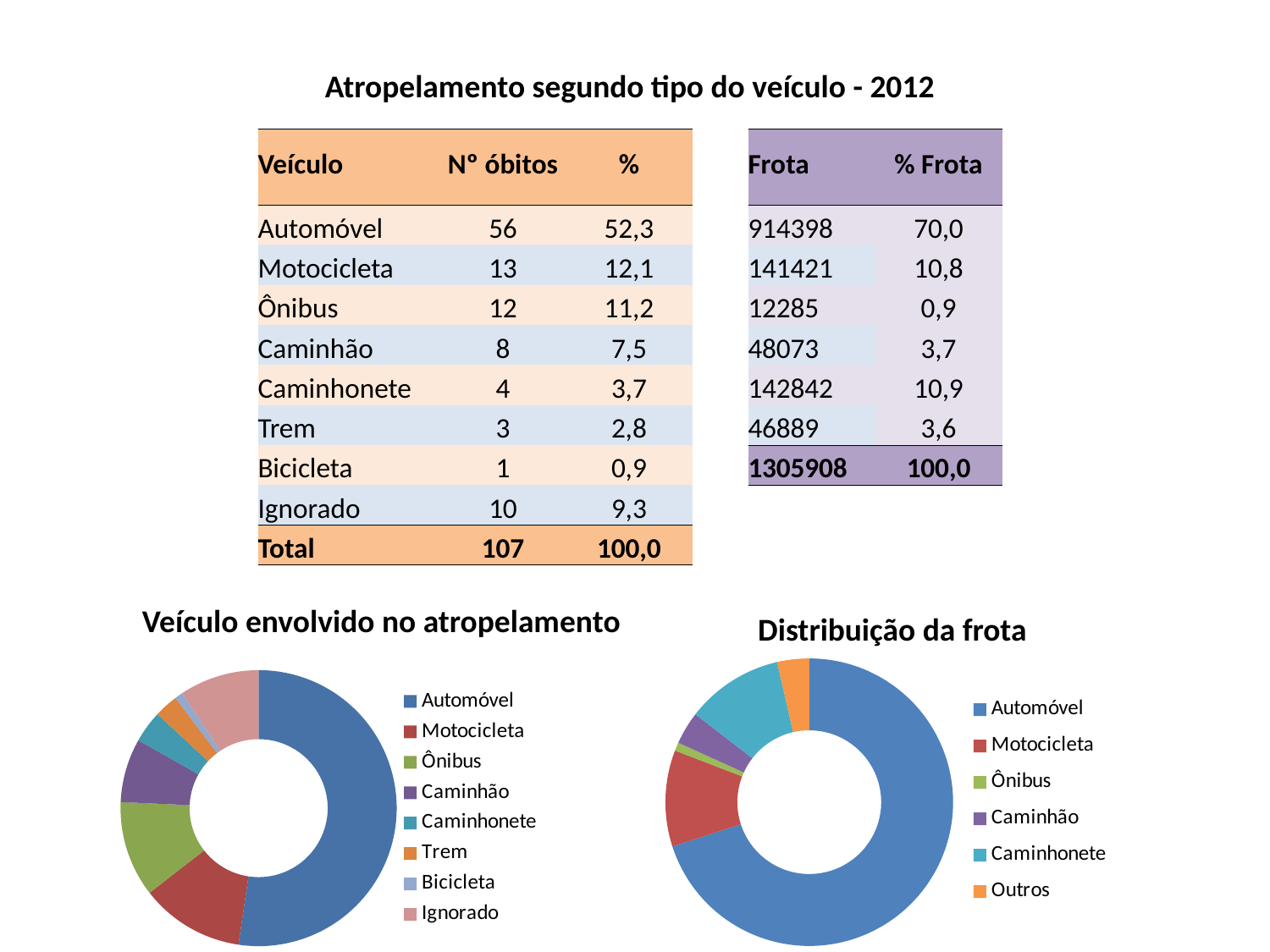
In the 'Veículo envolvido no atropelamento' chart, which category has the smallest slice? Bicicleta What kind of chart is 'Distribuição da frota'? Doughnut chart In the 'Distribuição da frota' chart, which slice is larger: Caminhonete or Caminhão? Caminhonete In the 'Veículo envolvido no atropelamento' chart, which category has the largest slice? Automóvel In the 'Veículo envolvido no atropelamento' chart, what share of the total does Automóvel represent, according to the table on the slide? 52,3 Which legend entry appears in the 'Distribuição da frota' chart but not in the 'Veículo envolvido no atropelamento' chart? Outros In the 'Veículo envolvido no atropelamento' chart, which slice is larger: Motocicleta or Caminhão? Motocicleta In the 'Distribuição da frota' chart, which category has the largest slice? Automóvel In the 'Distribuição da frota' chart, which category has the smallest slice? Ônibus In the 'Veículo envolvido no atropelamento' chart, how many categories does the legend list? 8 In the 'Distribuição da frota' chart, how many categories does the legend list? 6 What kind of chart is 'Veículo envolvido no atropelamento'? Doughnut chart